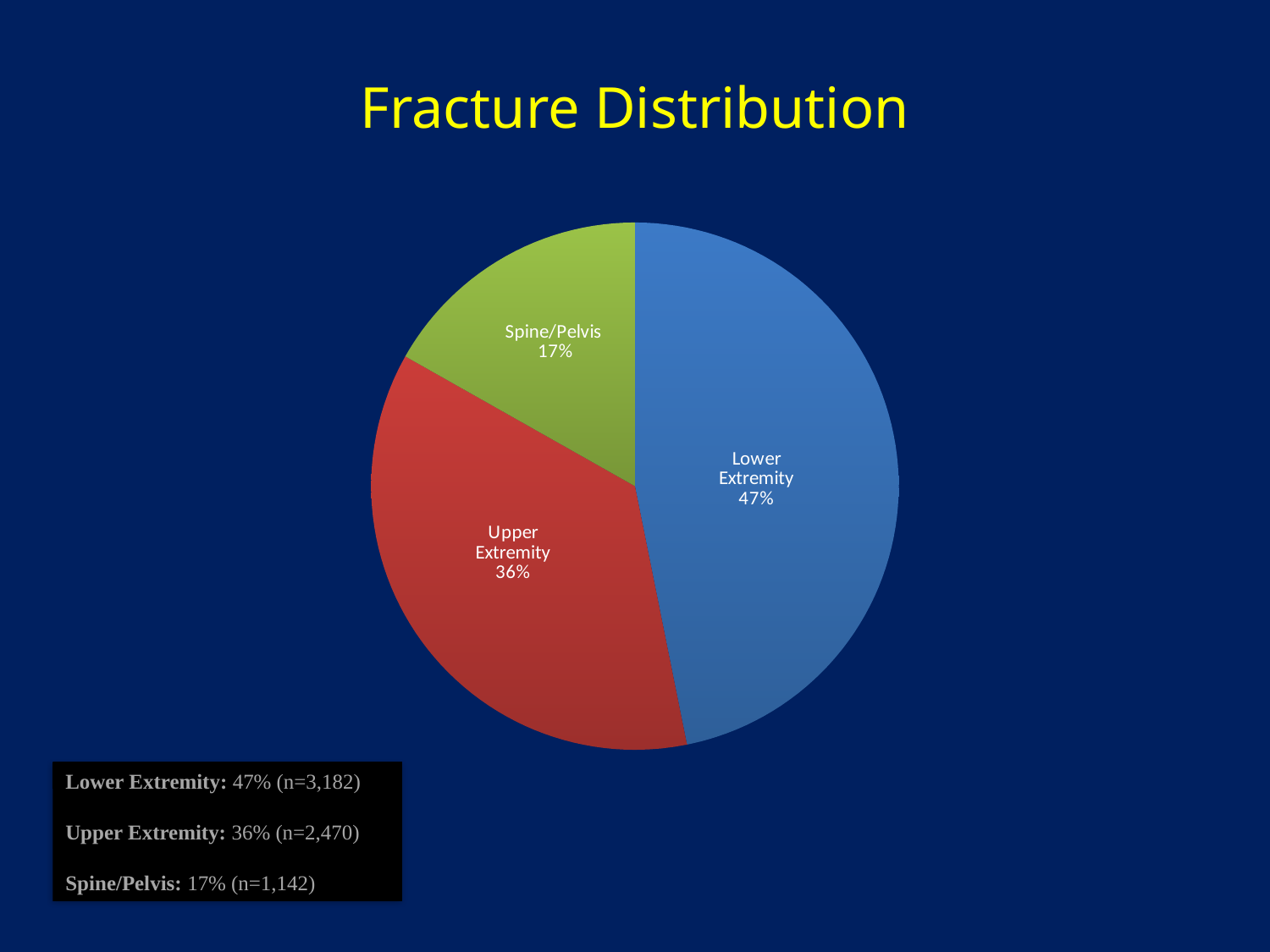
What is the title of the chart? Fracture Distribution How many slices does the pie chart have? 3 What kind of chart is shown on the slide? pie chart Which category has the smallest slice of the pie? Spine/Pelvis What percentage of the pie is Spine/Pelvis? 17% What is the difference in percentage points between Lower Extremity and Upper Extremity? 11 Which is larger, the Upper Extremity slice or the Spine/Pelvis slice? Upper Extremity Which category has the largest slice of the pie? Lower Extremity What percentage of the pie is Lower Extremity? 47% What percentage of the pie is Upper Extremity? 36% What colour is the Spine/Pelvis slice? green What is the difference in percentage points between Upper Extremity and Spine/Pelvis? 19